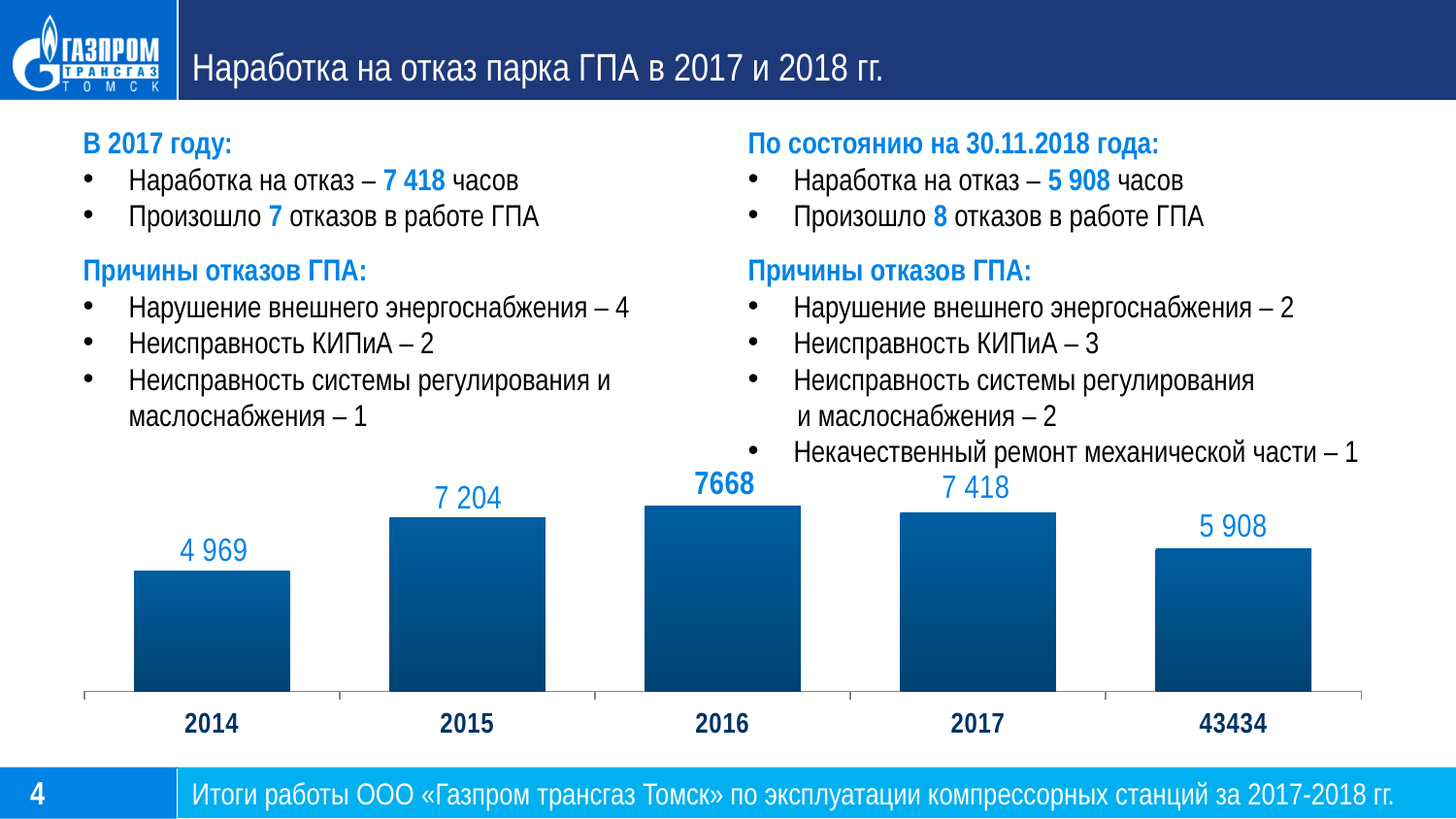
Which category has the lowest bar? 2014 What is the difference between the values for 2015 and 2014? 2 235 What kind of chart is shown on the slide? bar chart What is the difference between the values for 2017 and the bar labelled 43434? 1 510 What is the value of the bar for 2016? 7668 What is the value of the bar labelled 43434? 5 908 What is the value of the bar for 2014? 4 969 What is the value of the bar for 2017? 7 418 Which is larger, the value for 2015 or the value for 2017? 2017 How many bars are shown in the chart? 5 What is the value of the bar for 2015? 7 204 Which category has the highest bar? 2016